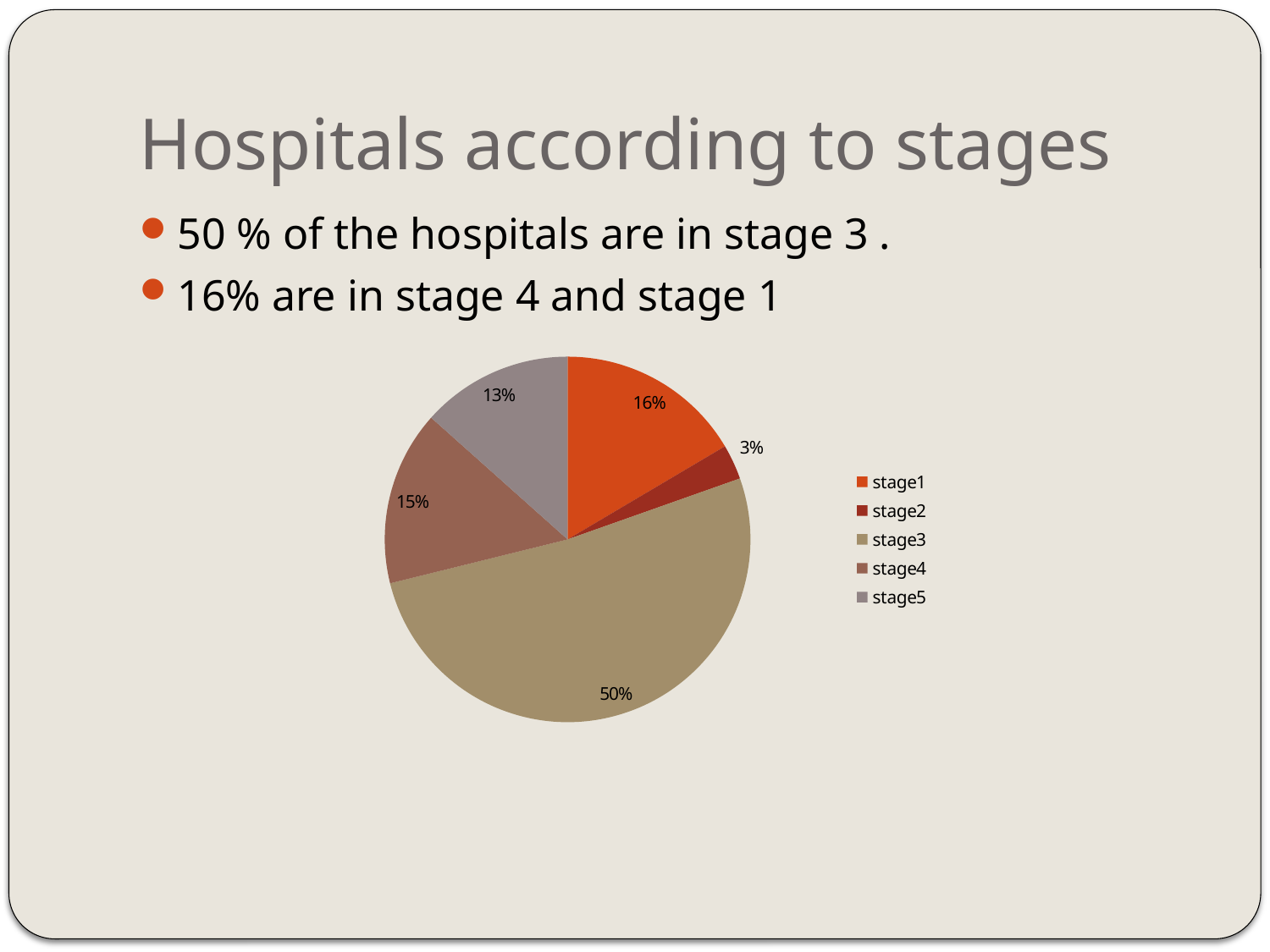
What is the difference in percentage points between stage3 and stage1? 34 What percentage is shown for stage5? 13% What percentage of the pie does stage3 represent? 50% What percentage is shown for stage2? 3% How many slices does the pie chart have? 5 What percentage is shown for stage4? 15% What kind of chart is shown on the slide? pie chart Which colour represents stage1 in the legend? orange What percentage is shown for stage1? 16% Which has a larger share, stage4 or stage5? stage4 Which stage has the smallest share of the pie? stage2 Which stage has the largest share of the pie? stage3